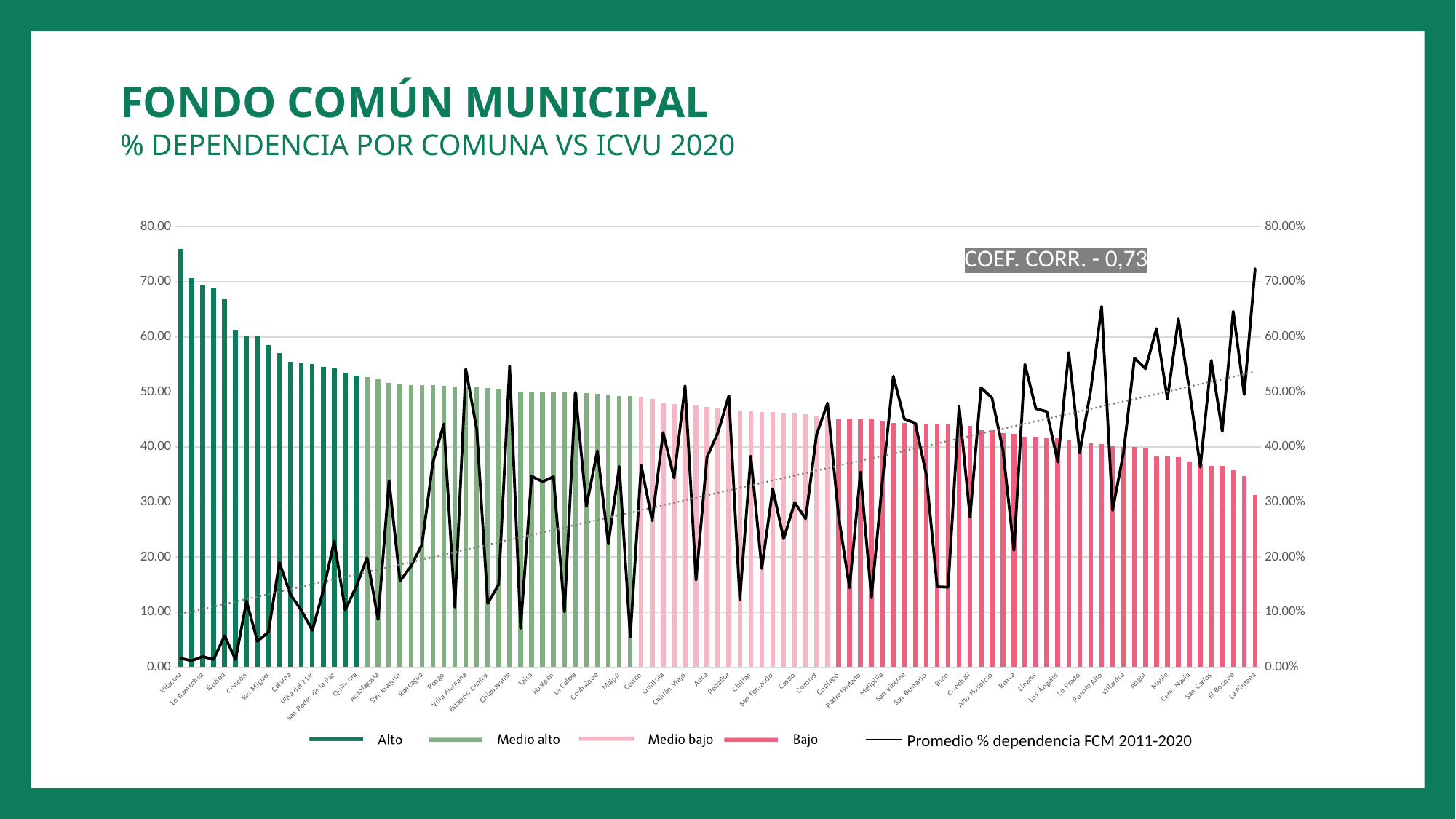
Which comuna has the highest bar on the chart? Vitacura Is the bar value for La Pintana greater or less than 40.00? less Which comuna has the lowest bar on the chart? La Pintana Do the bar values rise or fall from left to right along the x axis? Fall Is the 'Promedio % dependencia FCM 2011-2020' line value for La Pintana greater or less than 60.00%? greater Does the dotted trend line for 'Promedio % dependencia FCM 2011-2020' rise or fall from left to right? Rise How many series does the legend list? 5 What correlation coefficient is printed on the chart? - 0,73 Which has the larger bar value, Vitacura or La Pintana? Vitacura Is the bar value for Vitacura greater or less than 70.00? greater What kind of chart is shown on the slide? A bar chart combined with a line chart